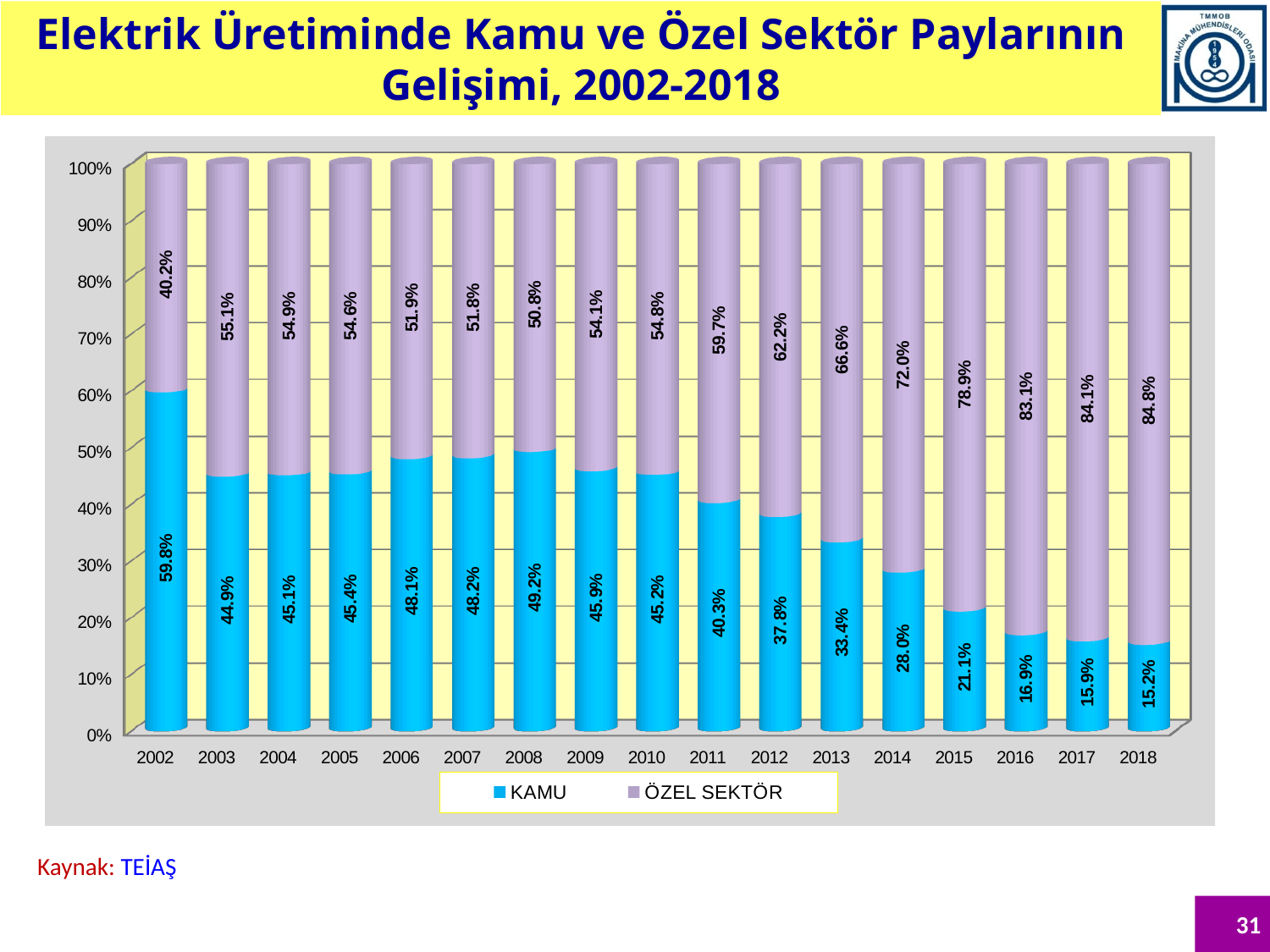
In which year is the KAMU share the lowest? 2018 What is the ÖZEL SEKTÖR share in 2018? 84.8% What is the ÖZEL SEKTÖR share in 2013? 66.6% Does the KAMU share rise or fall from 2011 to 2018? Fall Which year has the larger KAMU share, 2006 or 2008? 2008 What kind of chart is shown on the slide? Stacked bar chart By how many percentage points did the KAMU share fall from 2002 to 2018? 44.6 percentage points What is the KAMU share in 2010? 45.2% What is the KAMU share in 2002? 59.8% How many years are shown on the x axis? 17 In which year is the KAMU share the highest? 2002 How many series does the legend list? 2